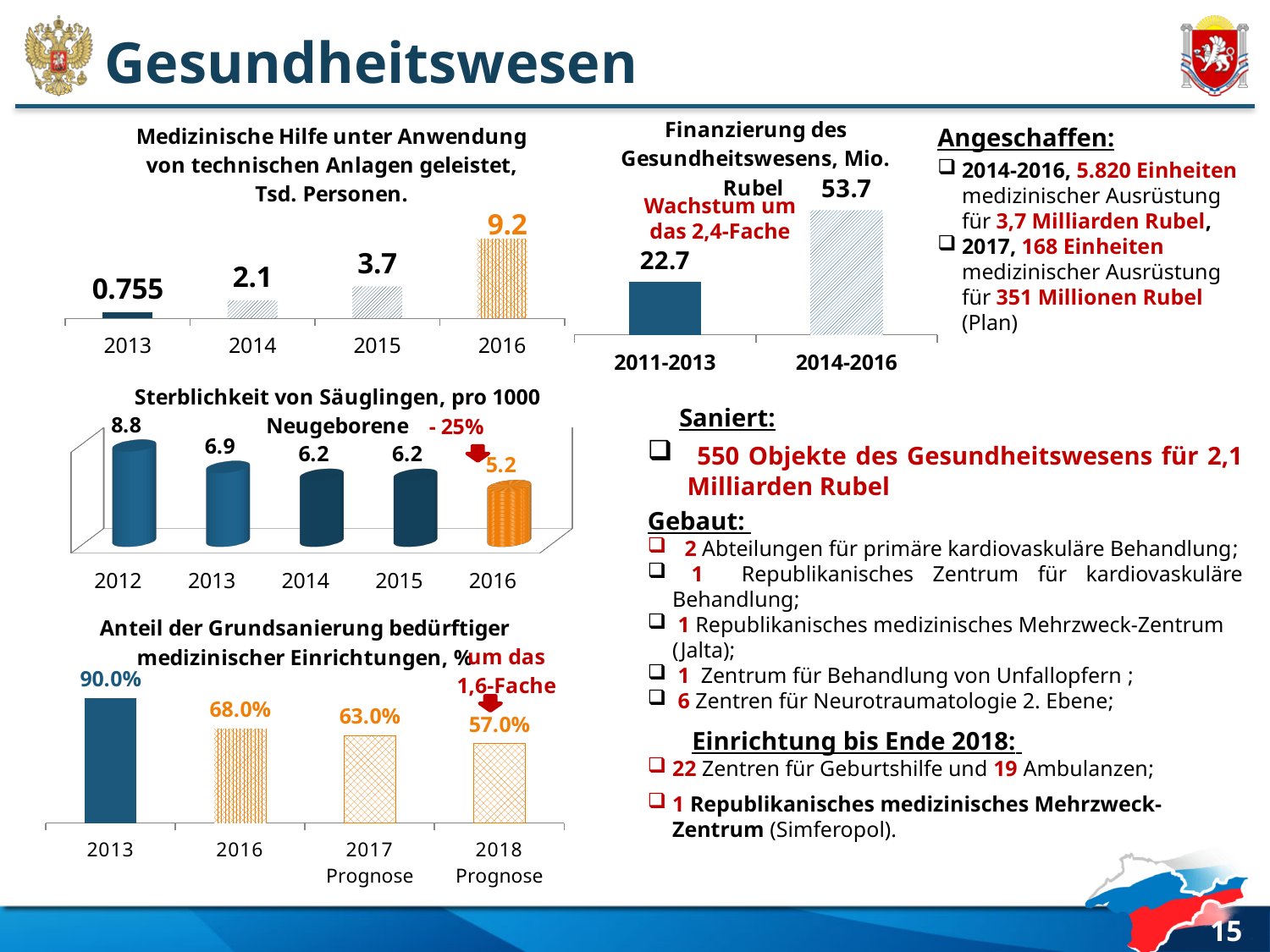
In the chart 'Medizinische Hilfe unter Anwendung von technischen Anlagen geleistet, Tsd. Personen', what is the value for 2016? 9.2 In the chart 'Finanzierung des Gesundheitswesens, Mio. Rubel', what is the value for 2011-2013? 22.7 In the chart 'Medizinische Hilfe unter Anwendung von technischen Anlagen geleistet, Tsd. Personen', do the values rise or fall from 2013 to 2016? rise In the chart 'Sterblichkeit von Säuglingen, pro 1000 Neugeborene', what is the value for 2012? 8.8 How many years are shown in the chart 'Sterblichkeit von Säuglingen, pro 1000 Neugeborene'? 5 In the chart 'Anteil der Grundsanierung bedürftiger medizinischer Einrichtungen, %', what is the value for 2018 Prognose? 57.0% How many bars are shown in the chart 'Finanzierung des Gesundheitswesens, Mio. Rubel'? 2 In the chart 'Sterblichkeit von Säuglingen, pro 1000 Neugeborene', which year has the lowest value? 2016 In the chart 'Medizinische Hilfe unter Anwendung von technischen Anlagen geleistet, Tsd. Personen', which year has the lowest value? 2013 In the chart 'Finanzierung des Gesundheitswesens, Mio. Rubel', what is the difference between the 2014-2016 and 2011-2013 values? 31.0 What kind of chart is 'Anteil der Grundsanierung bedürftiger medizinischer Einrichtungen, %'? bar chart In the chart 'Anteil der Grundsanierung bedürftiger medizinischer Einrichtungen, %', what is the difference between the 2013 and 2016 values? 22.0%